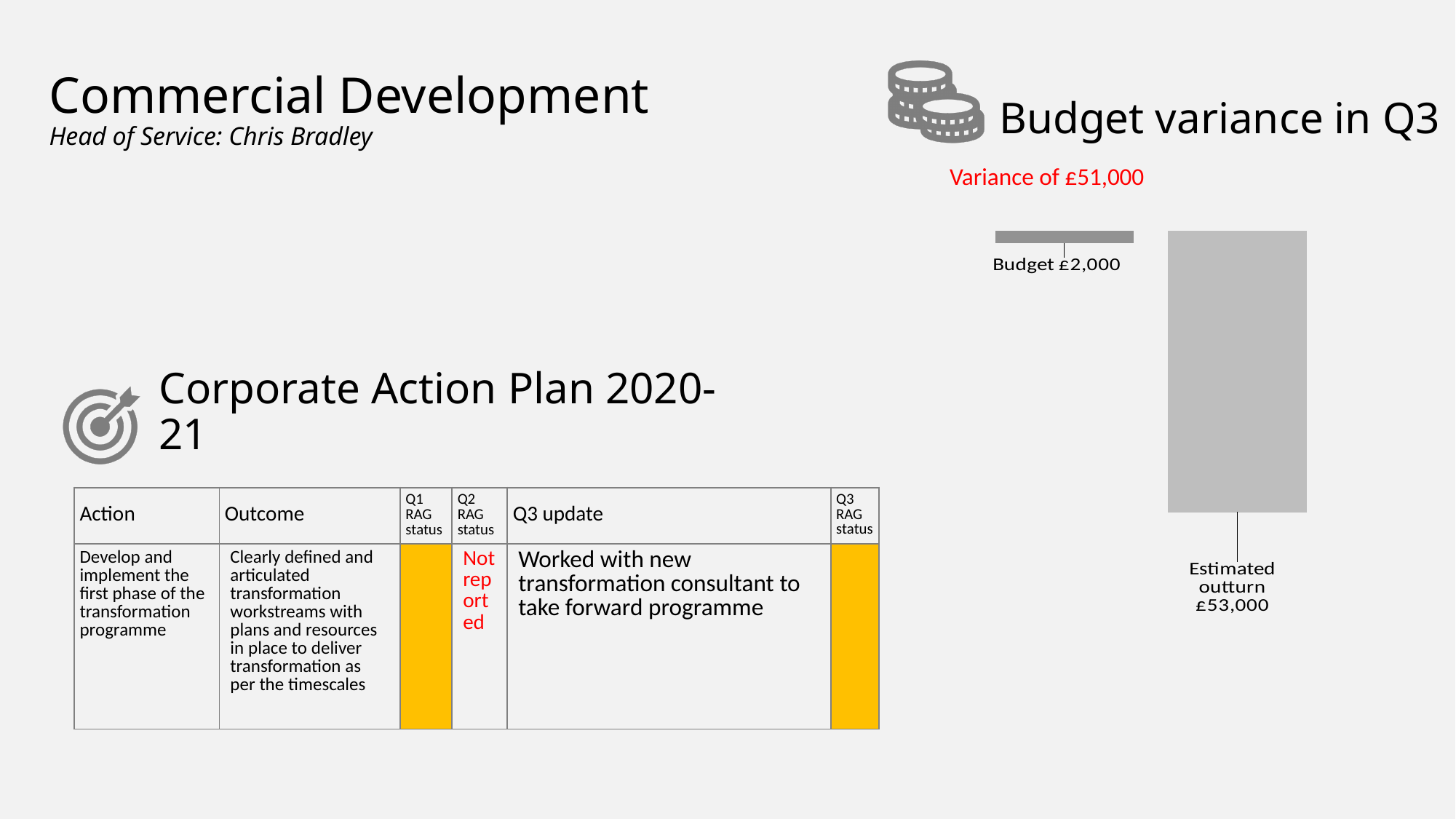
What is the value of the Estimated outturn bar in the Budget variance in Q3 chart? £53,000 What variance is stated above the Budget variance in Q3 chart? Variance of £51,000 Which bar is lowest in the Budget variance in Q3 chart? Budget Which bar is highest in the Budget variance in Q3 chart? Estimated outturn What colour are the bars in the Budget variance in Q3 chart? Grey How many bars are plotted in the Budget variance in Q3 chart? 2 What kind of chart is shown under the Budget variance in Q3 heading? Bar chart What is the value of the Budget bar in the Budget variance in Q3 chart? £2,000 Is the Budget or the Estimated outturn larger in the Budget variance in Q3 chart? Estimated outturn What is the difference between the Estimated outturn and the Budget in the Budget variance in Q3 chart? £51,000